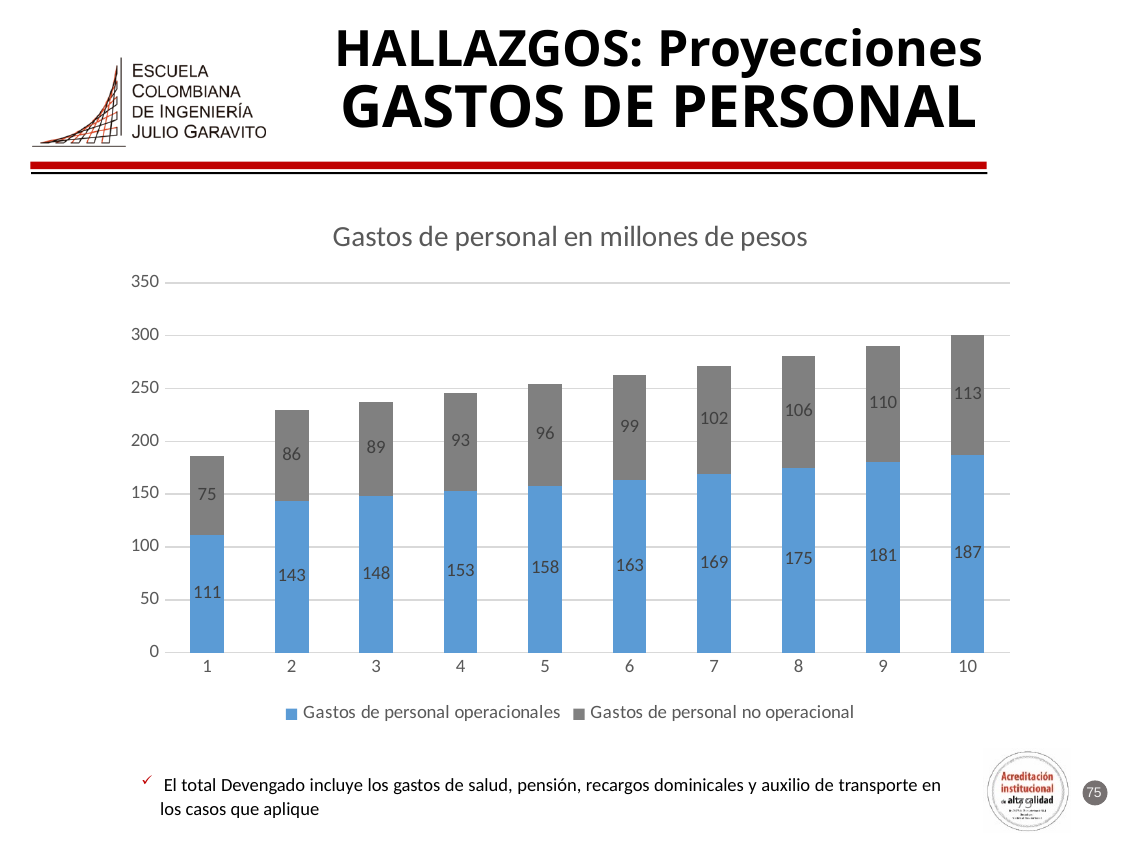
What is the value of Gastos de personal no operacional for category 10? 113 How many categories are shown on the x axis? 10 What is the total of the stacked bar for category 4? 246 What is the difference between Gastos de personal operacionales for category 10 and category 1? 76 Which category has the highest value for Gastos de personal operacionales? 10 Do the values for Gastos de personal operacionales rise or fall from category 1 to category 10? Rise Which is larger: Gastos de personal no operacional for category 7 or for category 3? Category 7 Which category has the lowest value for Gastos de personal no operacional? 1 What kind of chart is shown on the slide? Stacked bar chart What is the value of Gastos de personal operacionales for category 1? 111 What is the value of Gastos de personal operacionales for category 5? 158 How many series does the legend list? 2